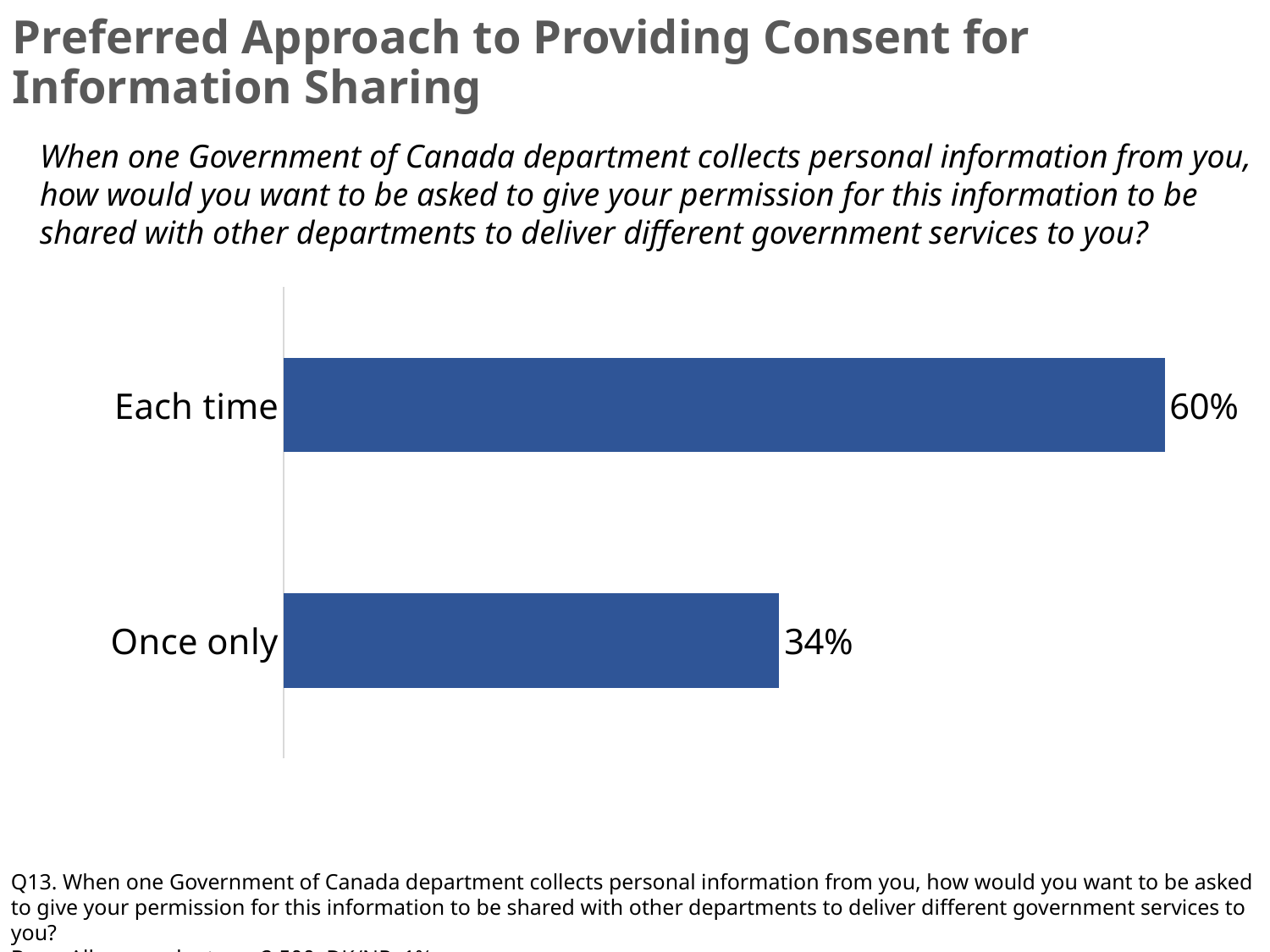
Which category has the highest value? Each time What is the title of the slide containing the chart? Preferred Approach to Providing Consent for Information Sharing What percentage of respondents prefer to give permission each time? 60% What colour are the bars in the chart? Blue What kind of chart is shown on the slide? Bar chart How many categories are shown in the chart? 2 Which is larger, the value for 'Each time' or the value for 'Once only'? Each time Which category has the lowest value? Once only What is the combined total of the two percentages shown? 94% What percentage of respondents prefer to give permission once only? 34% What is the difference in percentage points between 'Each time' and 'Once only'? 26